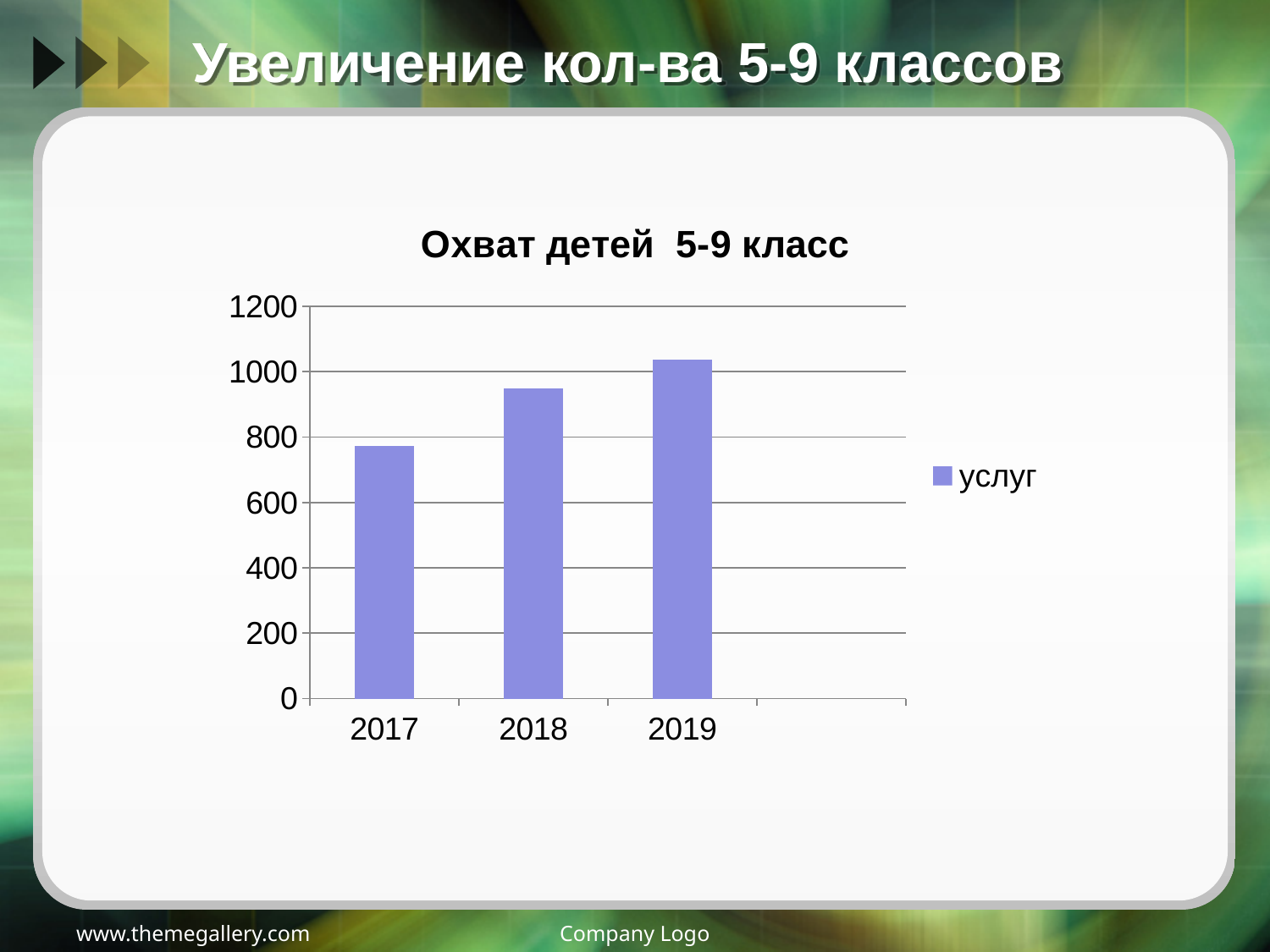
Which is larger, the value for 2018 or the value for 2017? 2018 How many series does the legend list? 1 Which year has the highest value? 2019 What is the title of the chart? Охват детей 5-9 класс Is the value for 2018 greater or less than 800? greater How many categories are shown on the x axis? 3 Which year has the lowest value? 2017 What kind of chart is shown on the slide? bar chart What is the name of the series in the legend? услуг Do the values rise or fall from 2017 to 2019? rise Is the value for 2017 greater or less than 800? less Is the value for 2019 greater or less than 1000? greater